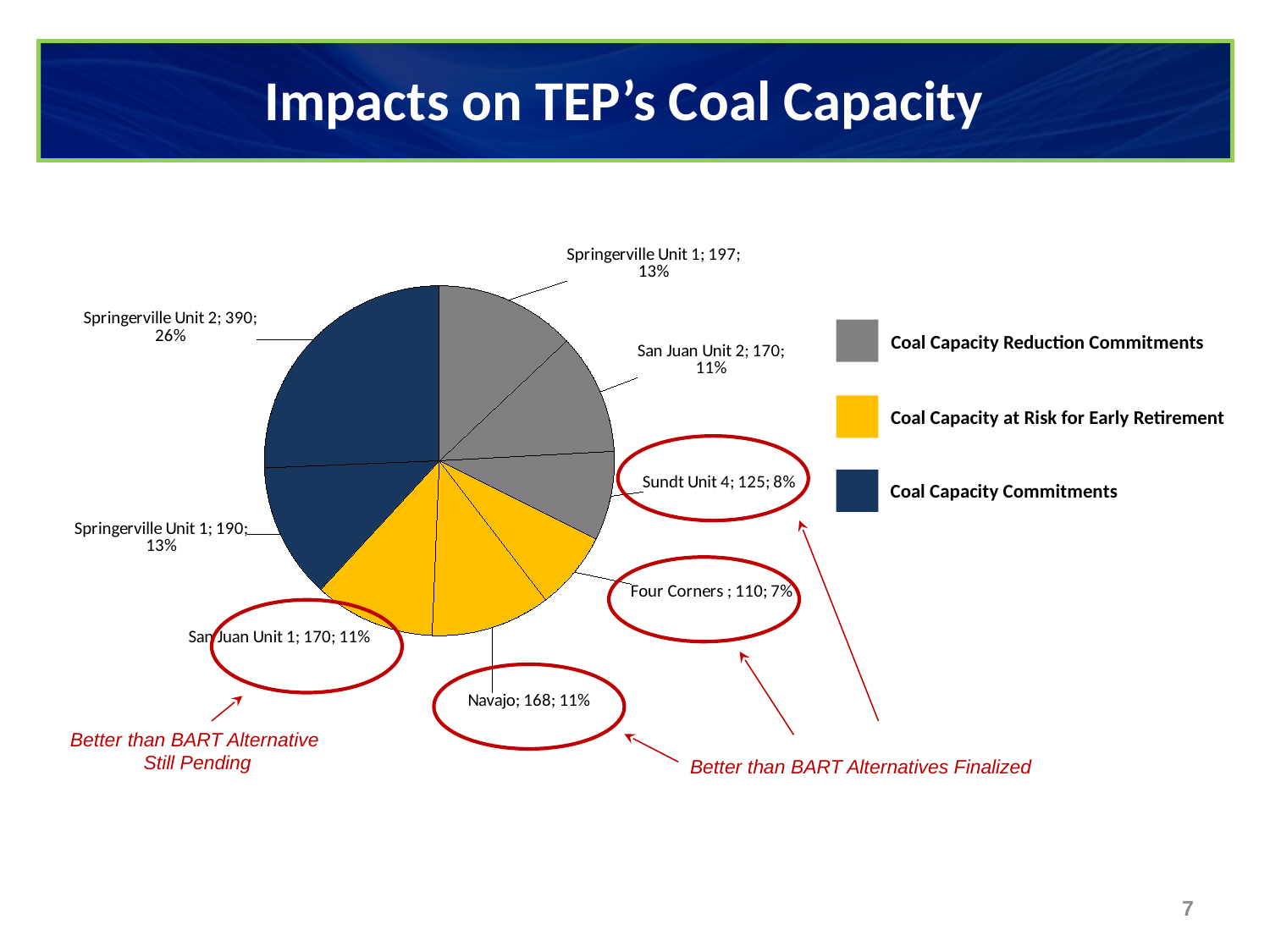
What percentage share of the pie does Four Corners represent? 7% What is the value shown for Springerville Unit 2? 390 What type of chart is shown on the slide? pie chart What percentage share of the pie does Springerville Unit 2 represent? 26% How many slices does the pie chart have? 8 What is the difference between the values for Springerville Unit 2 and Navajo? 222 What is the value shown for Sundt Unit 4? 125 Which is larger, the value for Sundt Unit 4 or the value for Four Corners? Sundt Unit 4 Which slice of the pie is the largest? Springerville Unit 2 What is the value shown for Navajo? 168 How many entries does the legend list? 3 Which slice of the pie is the smallest? Four Corners